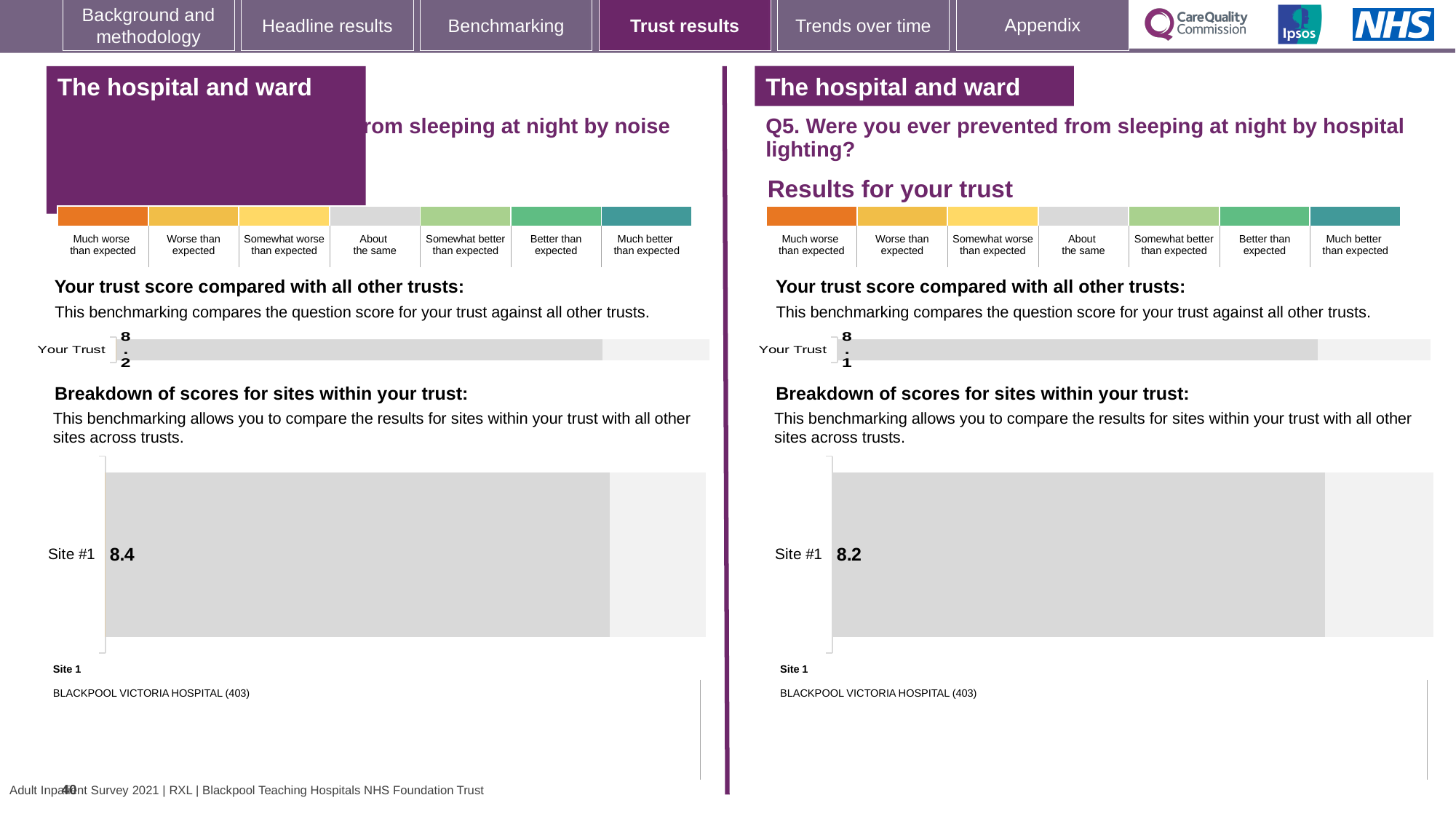
On the right-hand 'Your trust score compared with all other trusts' chart (Q5, hospital lighting), what is the value shown for Your Trust? 8.1 On the right-hand 'Breakdown of scores for sites within your trust' chart (Q5, hospital lighting), what is the score for Site #1? 8.2 According to the site key below the right-hand breakdown chart (Q5), which hospital is Site 1? BLACKPOOL VICTORIA HOSPITAL (403) What type of chart is used for the 'Breakdown of scores for sites within your trust' on the left-hand side of the slide? Bar chart Which of the two 'Your trust score compared with all other trusts' charts shows the larger Your Trust value: the left (noise) or the right (Q5, hospital lighting)? The left (noise) How many sites are shown in the right-hand 'Breakdown of scores for sites within your trust' chart (Q5)? 1 Comparing the Site #1 scores in the two site breakdown charts, which question has the higher Site #1 score: the noise question on the left or the hospital lighting question (Q5) on the right? The noise question on the left On the left-hand side of the slide (sleeping at night by noise), what is the difference between the Site #1 score and the Your Trust score? 0.2 On the left-hand 'Your trust score compared with all other trusts' chart (sleeping at night by noise), what is the value shown for Your Trust? 8.2 On the left-hand 'Breakdown of scores for sites within your trust' chart (sleeping at night by noise), what is the score for Site #1? 8.4 On the right-hand side of the slide (Q5, hospital lighting), what is the difference between the Site #1 score and the Your Trust score? 0.1 What is the difference between the Your Trust scores shown on the left-hand and right-hand 'Your trust score compared with all other trusts' charts? 0.1